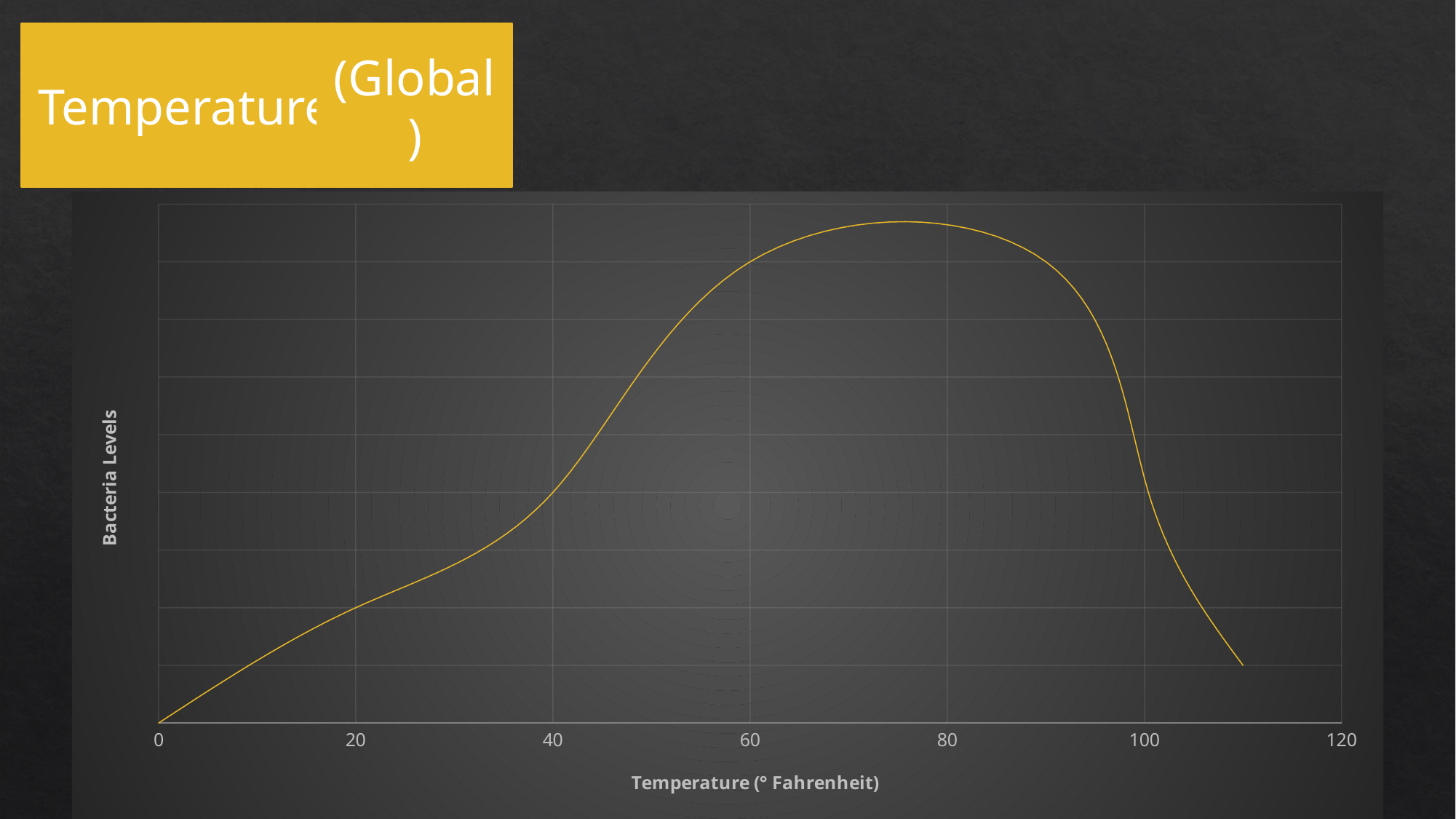
What is the highest temperature value labelled on the x axis? 120 What is the title of the x axis of the chart? Temperature (° Fahrenheit) What kind of chart is shown on the slide? line chart Is the bacteria level higher at 60 °F or at 20 °F? 60 °F Is the bacteria level higher at 80 °F or at 110 °F? 80 °F At which labelled temperature is the bacteria level lowest, 0 °F or 80 °F? 0 °F Do bacteria levels rise or fall as temperature increases from 0 to 60 °F? rise What is the title of the y axis of the chart? Bacteria Levels Does the curve reach its peak between 60 and 80 °F or between 100 and 120 °F? between 60 and 80 °F How many tick labels are shown on the x axis? 7 Do bacteria levels rise or fall as temperature increases from 100 to 110 °F? fall